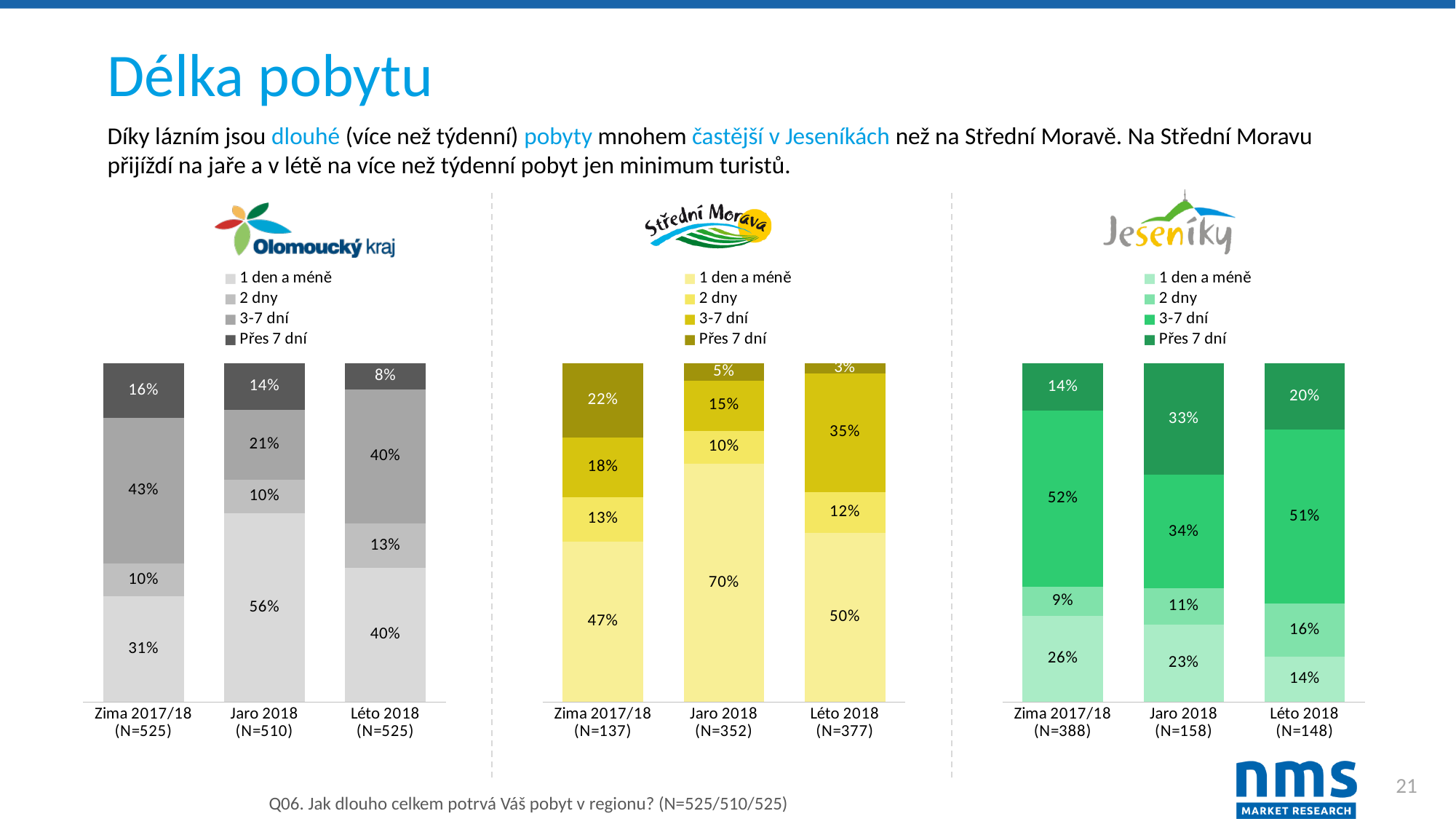
In the Střední Morava chart, does the 'Přes 7 dní' value rise or fall from Zima 2017/18 to Léto 2018? Fall Which is larger: the 'Přes 7 dní' value for Zima 2017/18 in the Střední Morava chart or in the Jeseníky chart? Střední Morava In the Olomoucký kraj chart, what is the value for 'Přes 7 dní' in Léto 2018? 8% In the Střední Morava chart, what is the value for '3-7 dní' in Léto 2018? 35% In the Jeseníky chart, which season has the lowest value for '1 den a méně'? Léto 2018 What type of chart is used for the Olomoucký kraj data? Stacked bar chart How many seasons (categories) are shown in the Jeseníky chart? 3 In the Olomoucký kraj chart, what is the difference between the '3-7 dní' values for Zima 2017/18 and Jaro 2018? 22% How many series does the legend of the Střední Morava chart list? 4 In the Olomoucký kraj chart, what is the value for '1 den a méně' in Jaro 2018? 56% In the Střední Morava chart, which season has the highest value for '1 den a méně'? Jaro 2018 In the Jeseníky chart, what is the value for 'Přes 7 dní' in Jaro 2018? 33%